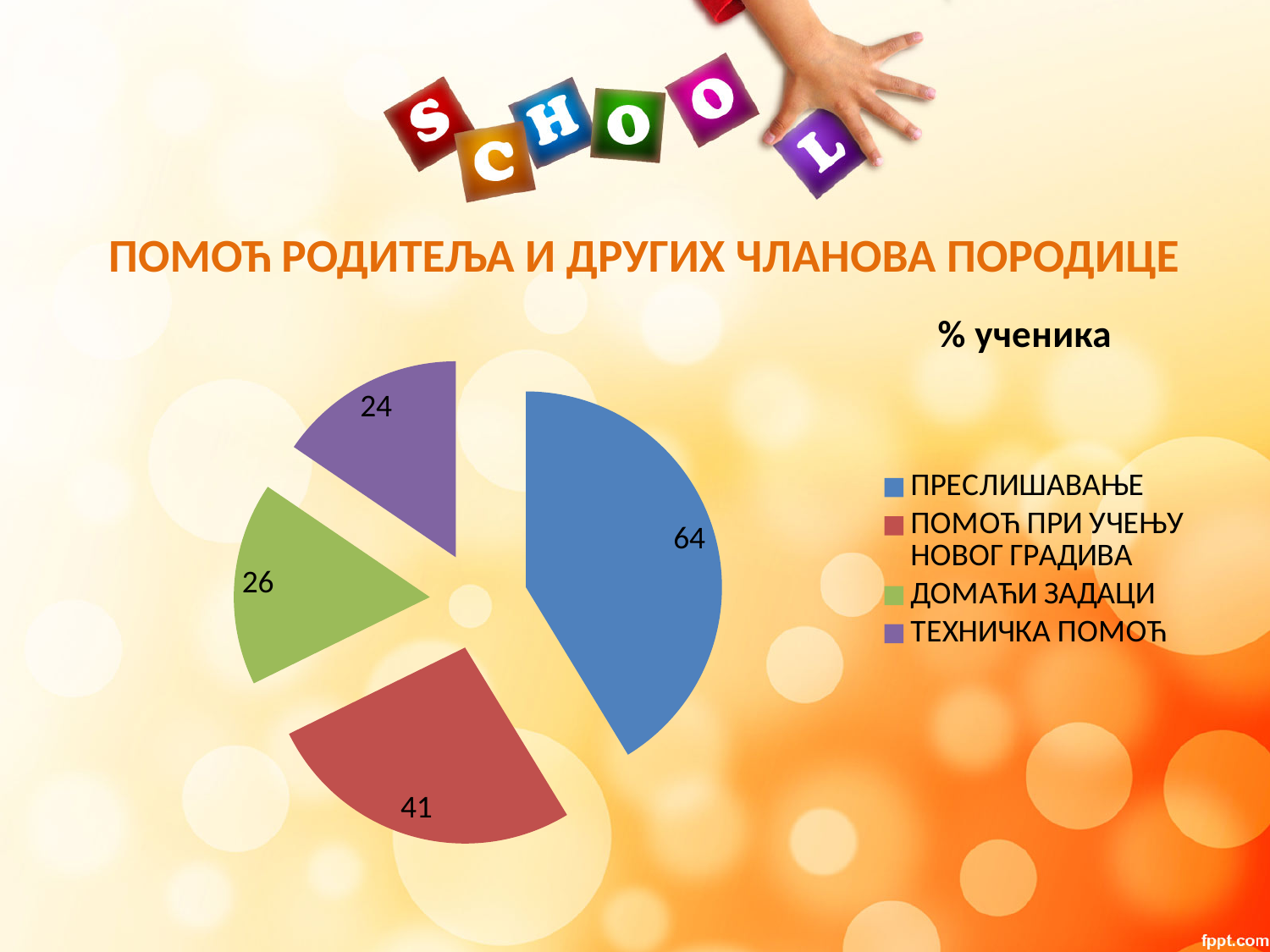
What is the value for ПРЕСЛИШАВАЊЕ? 64 Which category has the highest value? ПРЕСЛИШАВАЊЕ What kind of chart is shown on the slide? pie chart Which category has the lowest value? ТЕХНИЧКА ПОМОЋ What is the value for ПОМОЋ ПРИ УЧЕЊУ НОВОГ ГРАДИВА? 41 What is the value for ТЕХНИЧКА ПОМОЋ? 24 What is the value for ДОМАЋИ ЗАДАЦИ? 26 What is the title of the chart? % ученика Which is larger, the value for ДОМАЋИ ЗАДАЦИ or the value for ТЕХНИЧКА ПОМОЋ? ДОМАЋИ ЗАДАЦИ What is the difference between the values for ПРЕСЛИШАВАЊЕ and ПОМОЋ ПРИ УЧЕЊУ НОВОГ ГРАДИВА? 23 How many slices does the pie chart have? 4 What is the difference between the values for ДОМАЋИ ЗАДАЦИ and ТЕХНИЧКА ПОМОЋ? 2